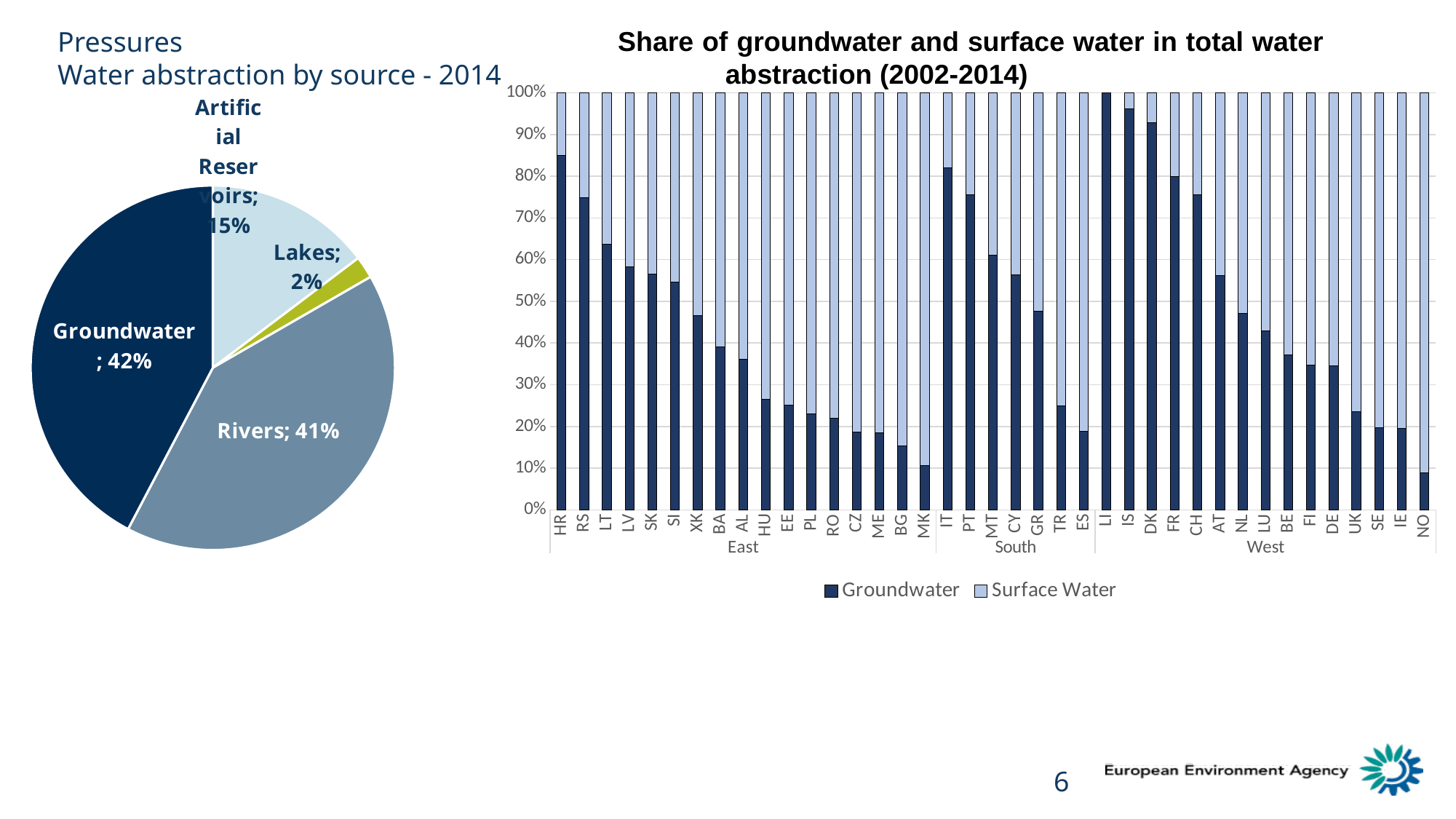
What are the three regional groups labelled on the x axis of the chart on the right? East, South, West In the chart on the right, is the Groundwater share for HR greater or less than 80%? greater In the chart on the right, is the Groundwater share for MK greater or less than 20%? less What kind of chart is the chart on the right titled 'Share of groundwater and surface water in total water abstraction (2002-2014)'? Stacked bar chart How many series does the legend of the chart on the right list? 2 In the pie chart on the left, what share of water abstraction comes from Lakes? 2% In the pie chart on the left, what share of water abstraction comes from Rivers? 41% In the pie chart on the left, what share of water abstraction comes from Groundwater? 42% How many slices does the pie chart on the left have? 4 In the pie chart on the left, what is the difference in percentage points between the Groundwater share and the Artificial Reservoirs share? 27 In the pie chart on the left, which source has the smallest share? Lakes In the chart on the right, which has the larger Groundwater share, IT or ES? IT